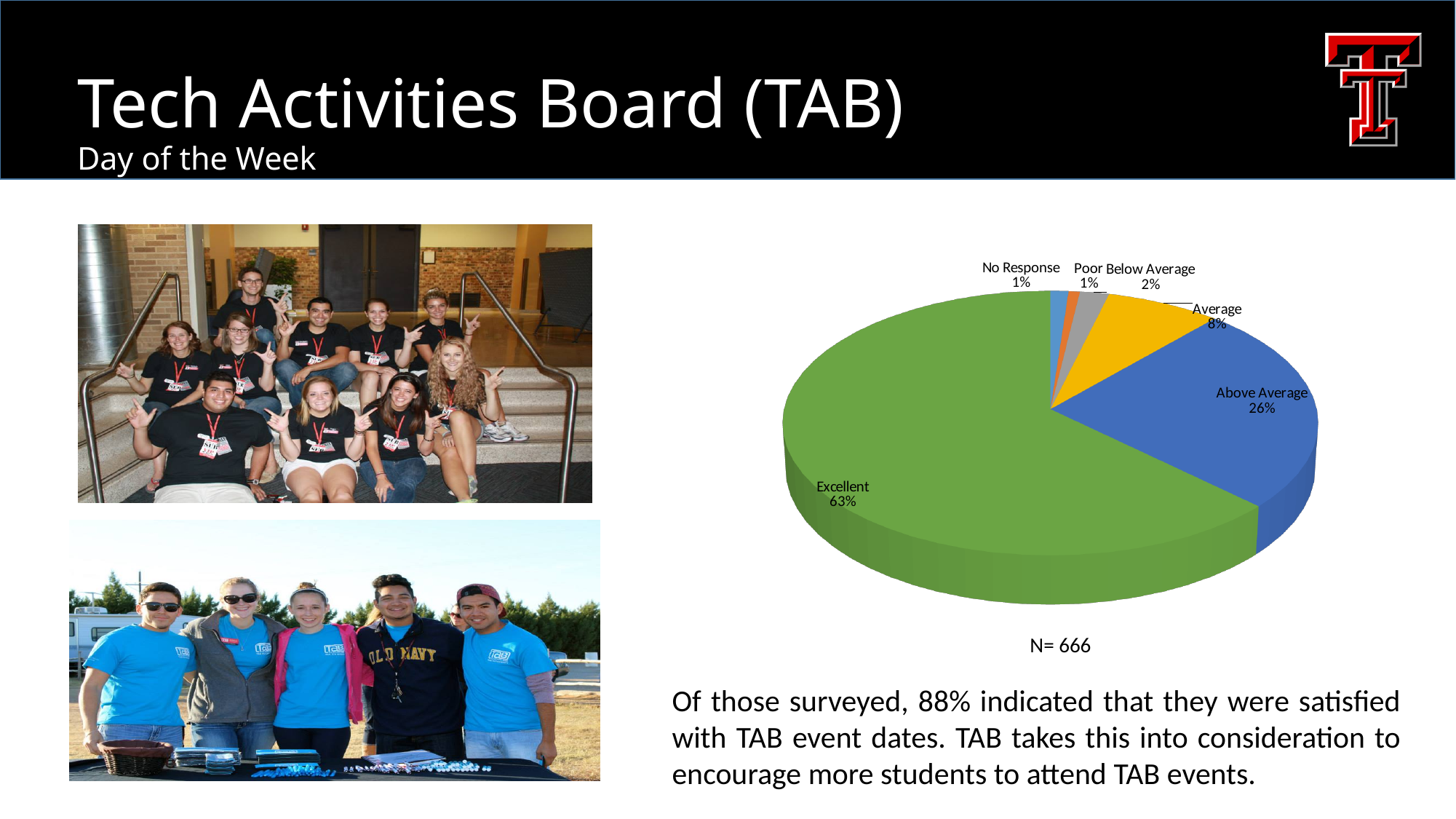
What percentage of respondents gave No Response? 1% What percentage of respondents rated the day of the week as Below Average? 2% What is the difference in percentage points between Excellent and Above Average? 37 How many categories are shown in the pie chart? 6 What kind of chart is shown on the slide? pie chart What is the combined share of Excellent and Above Average? 89% What percentage of respondents rated the day of the week as Excellent? 63% Which category has the largest share of the pie? Excellent Which is larger, the share for Average or the share for Below Average? Average What percentage of respondents rated the day of the week as Average? 8% What is the sample size (N) shown below the chart? N= 666 What percentage of respondents rated the day of the week as Above Average? 26%